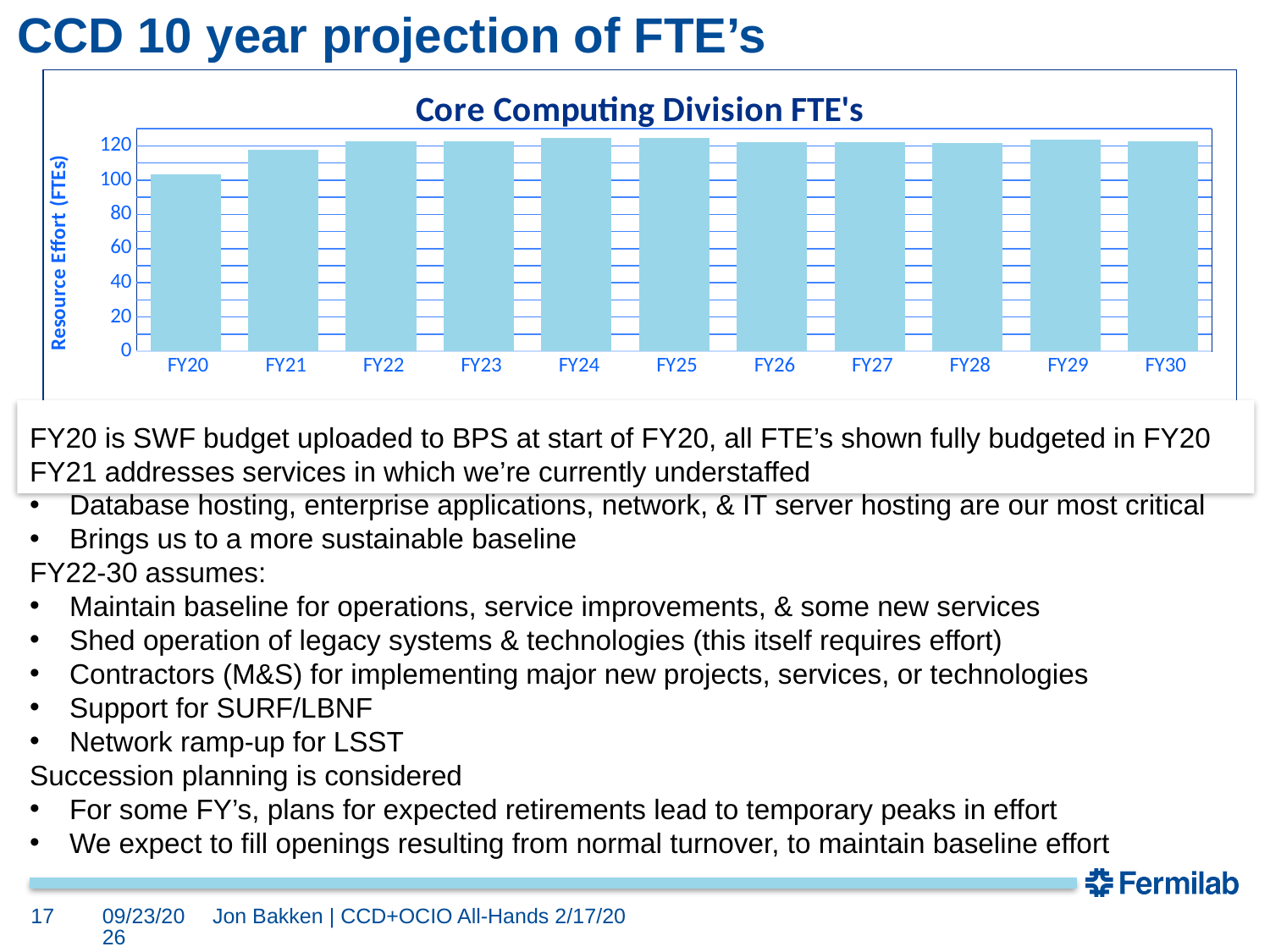
Does the value rise or fall from FY20 to FY21? rise Is the value for FY20 greater or less than 120? less Which is larger, the value for FY20 or the value for FY24? FY24 What is the title of the chart? Core Computing Division FTE's Which fiscal year has the lowest value in the chart? FY20 Is the value for FY21 greater or less than 120? less What kind of chart is shown on the slide? bar chart Is the value for FY24 greater or less than 120? greater What is the label on the y axis of the chart? Resource Effort (FTEs) Which is larger, the value for FY20 or the value for FY21? FY21 How many fiscal years are plotted on the x axis of the chart? 11